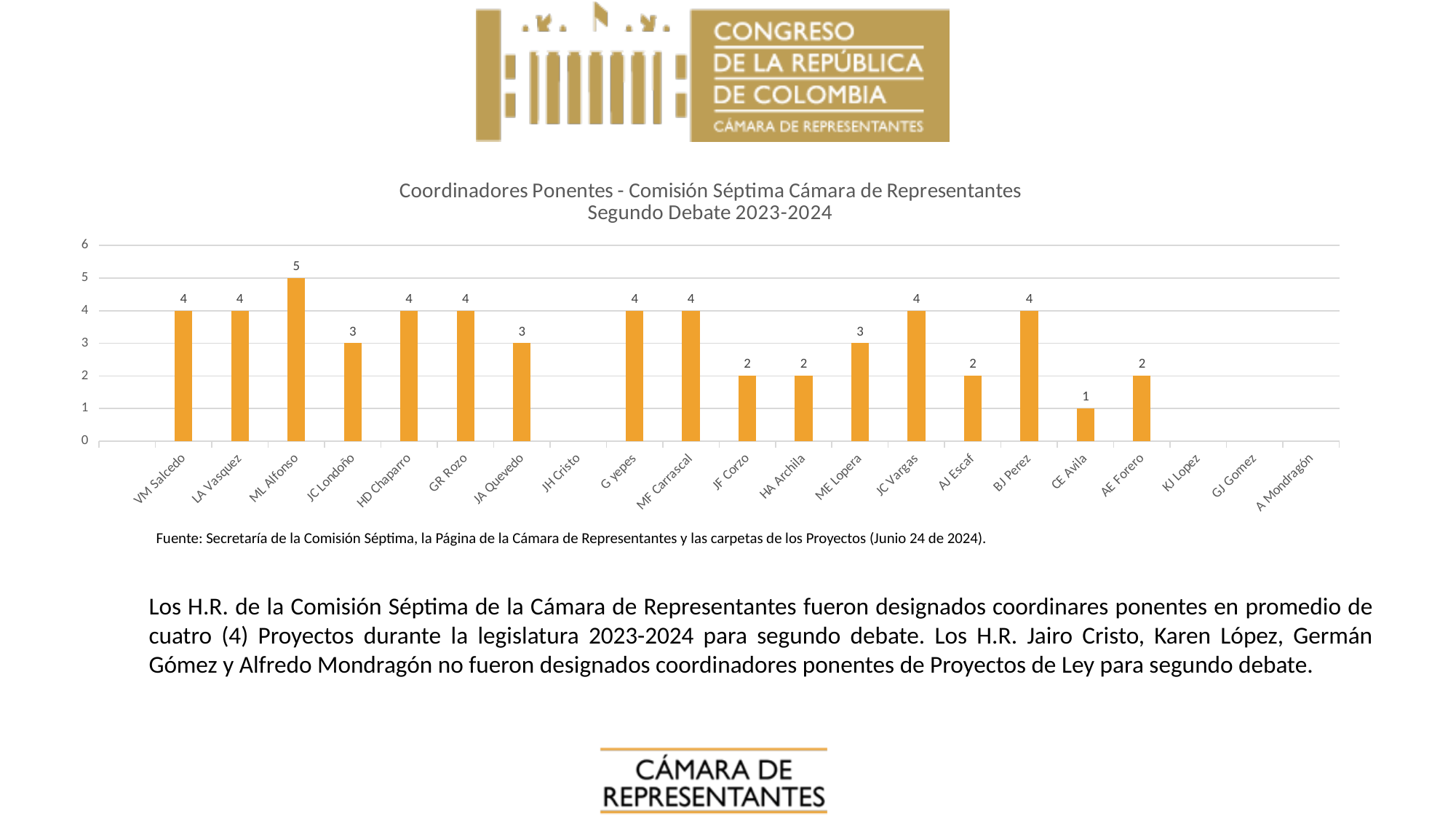
What is the title of the chart? Coordinadores Ponentes - Comisión Séptima Cámara de Representantes Segundo Debate 2023-2024 What is the difference between the values for ML Alfonso and JF Corzo? 3 What is the value for CE Avila? 1 Among the representatives with a visible bar, which one has the lowest value? CE Avila Which is larger, the value for ME Lopera or the value for HA Archila? ME Lopera What is the value for JC Londoño? 3 What is the value for ML Alfonso? 5 Which representative has the highest value in the chart? ML Alfonso What is the value for JC Vargas? 4 What is the value for AE Forero? 2 How many representatives are listed on the x axis of the chart? 21 What kind of chart is shown on the slide? Bar chart